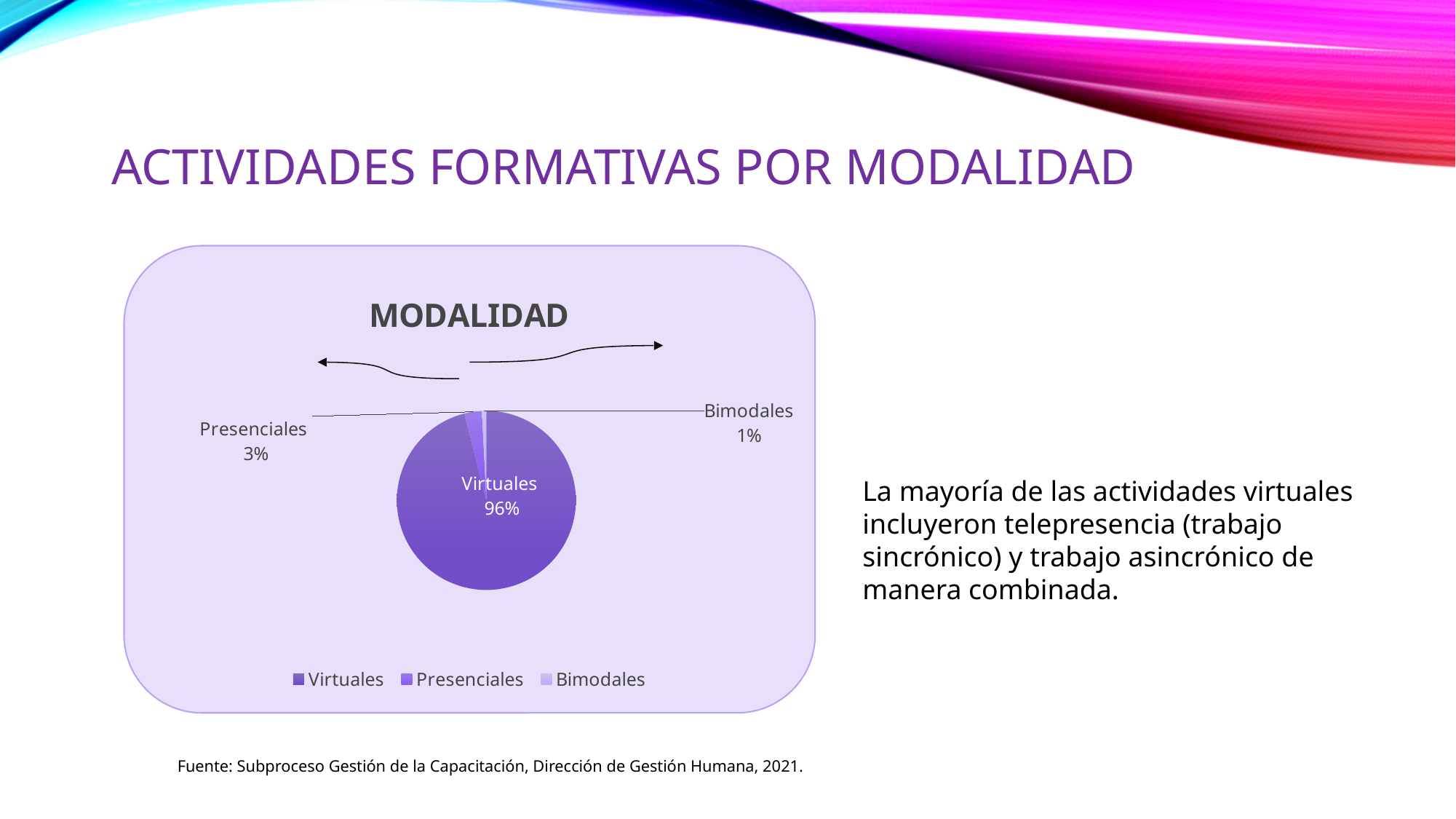
What percentage of the pie is Virtuales? 96% What is the difference in percentage points between Virtuales and Presenciales? 93 What is the difference in percentage points between Presenciales and Bimodales? 2 What percentage of the pie is Bimodales? 1% How many entries does the legend list? 3 Which category has the smallest share of the pie? Bimodales What type of chart is shown on the slide? pie chart What is the title of the chart? MODALIDAD What percentage of the pie is Presenciales? 3% Which is larger, the share for Presenciales or the share for Bimodales? Presenciales Which category has the largest share of the pie? Virtuales How many categories does the pie chart have? 3